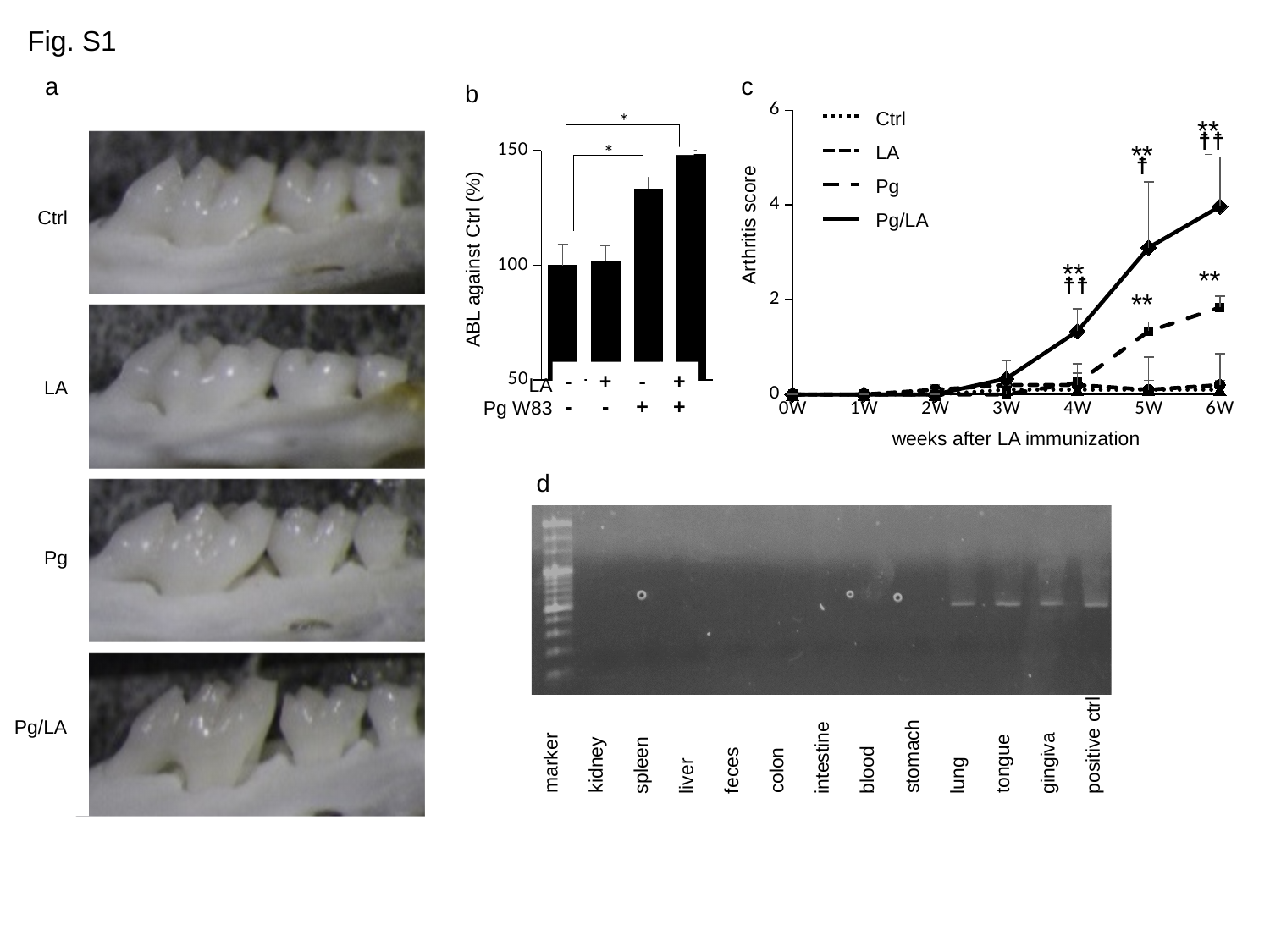
In panel b (ABL against Ctrl), which bar is taller: the LA-only bar (LA +, Pg W83 -) or the Pg W83-only bar (LA -, Pg W83 +)? Pg W83-only bar (LA -, Pg W83 +) What kind of chart is panel b (ABL against Ctrl)? bar chart In panel c (Arthritis score), how many series does the legend list? 4 In panel c, what is the label of the x axis? weeks after LA immunization In panel b (ABL against Ctrl), is the value for the Pg W83-only bar (LA -, Pg W83 +) greater or less than 100? greater What kind of chart is panel c (Arthritis score)? line chart In panel c (Arthritis score), which series has the highest value at 6W? Pg/LA In panel b (ABL against Ctrl), how many bars are plotted? 4 In panel c (Arthritis score), how many time points are shown on the x axis? 7 In panel c (Arthritis score), is the Pg value at 5W greater or less than 2? less In panel c (Arthritis score), is the Pg/LA value at 5W greater or less than 2? greater In panel b (ABL against Ctrl), which condition has the highest bar? LA + and Pg W83 + (Pg/LA)